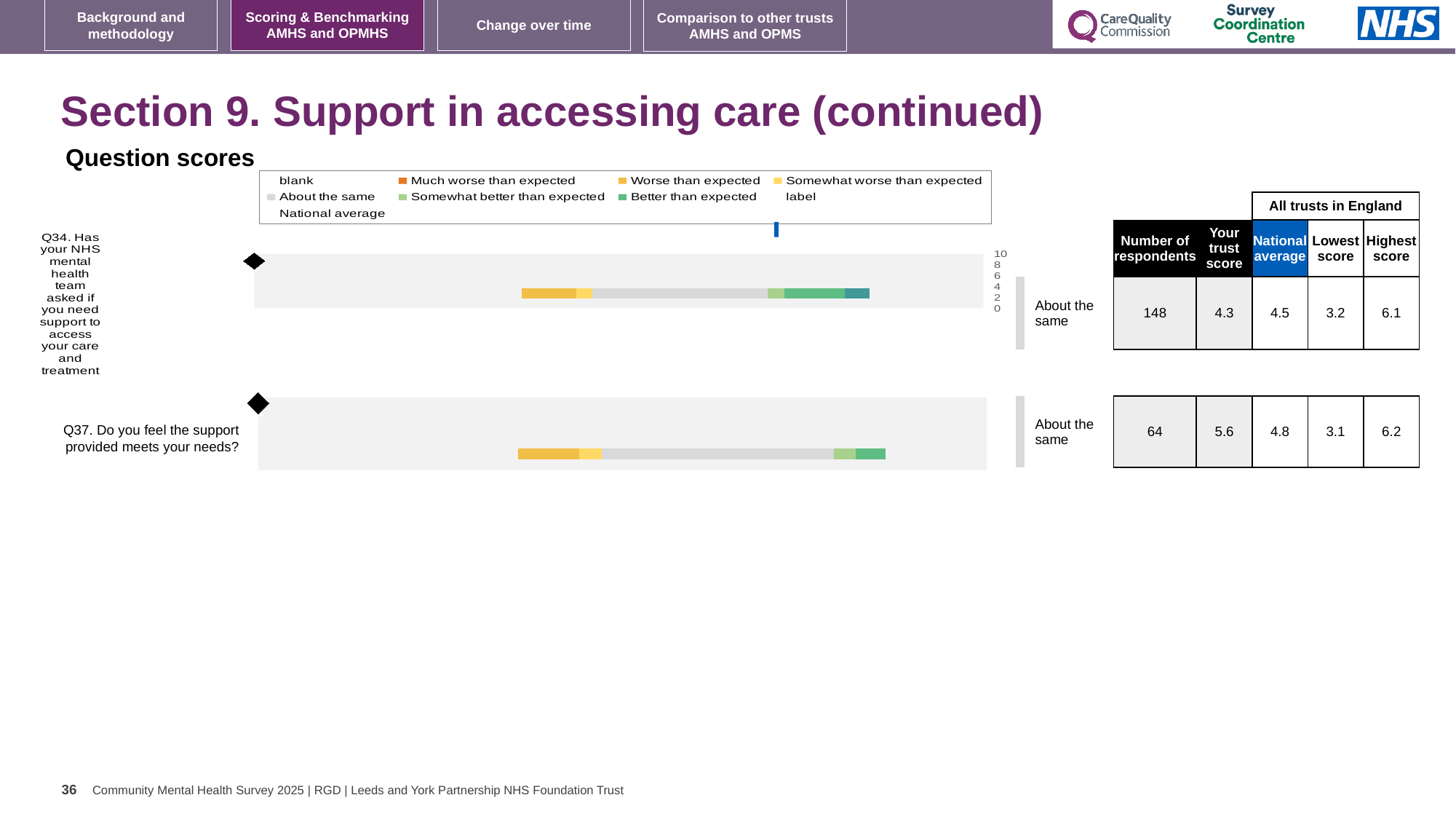
In the table, what is the number of respondents for Q34? 148 In the table, what is the national average for Q34? 4.5 In the table, what is the trust score for Q37? 5.6 In the legend, which colour represents 'Much worse than expected'? orange Which question has the higher trust score, Q34 or Q37? Q37 What is the difference between the highest and lowest score for Q34? 2.9 What is the difference between the trust score and the national average for Q37? 0.8 What kind of chart is used to show the question scores for Q34 and Q37? bar chart In the table, what is the highest score for Q37? 6.2 What benchmark rating is shown next to the Q37 chart? About the same How many questions are plotted on the slide? 2 What benchmark rating is shown next to the Q34 chart? About the same